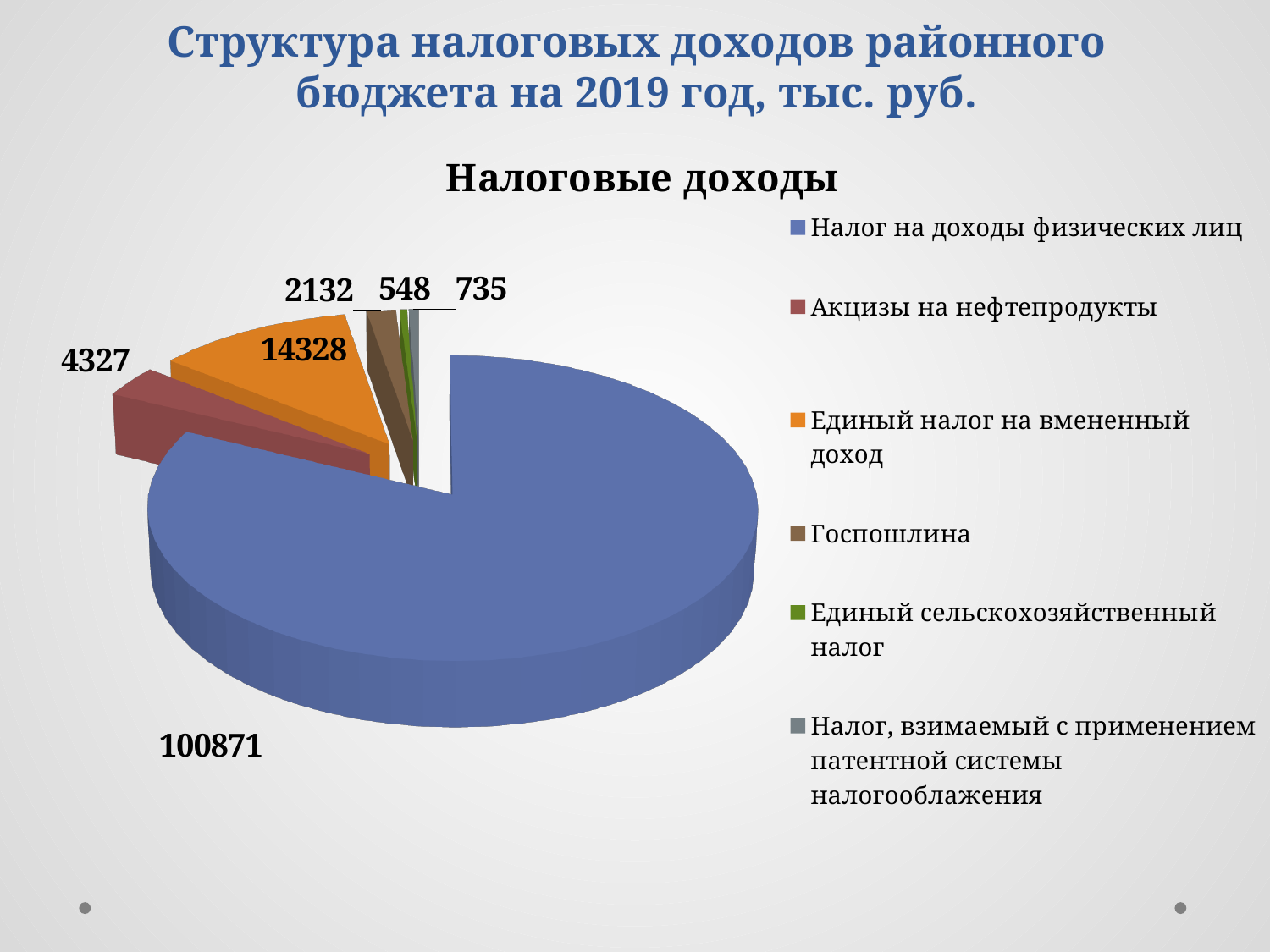
What is the value for Налог на доходы физических лиц? 100871 Which is larger: Налог, взимаемый с применением патентной системы налогооблажения or Единый сельскохозяйственный налог? Налог, взимаемый с применением патентной системы налогооблажения What is the title of the chart? Налоговые доходы What type of chart is shown on the slide? Pie chart Which category has the largest slice of the pie? Налог на доходы физических лиц What is the value for Акцизы на нефтепродукты? 4327 Which category has the smallest slice of the pie? Единый сельскохозяйственный налог What is the value for Единый сельскохозяйственный налог? 548 What is the difference between Единый налог на вмененный доход and Акцизы на нефтепродукты? 10001 How many categories does the pie chart have? 6 What is the value for Единый налог на вмененный доход? 14328 What is the value for Госпошлина? 2132